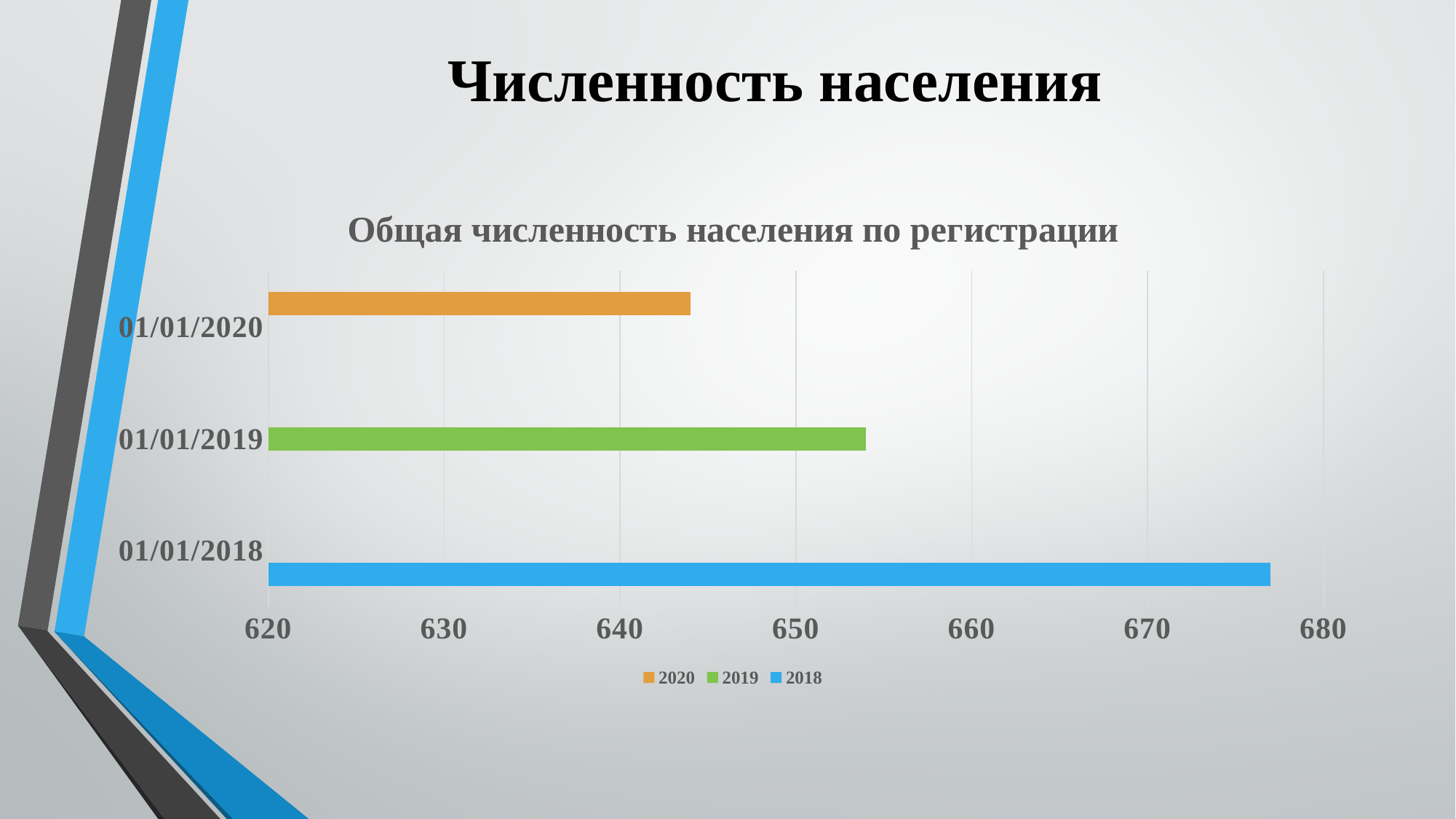
Is the value for 01/01/2019 greater or less than 650? greater Which category has the highest value? 01/01/2018 Which is larger, the value for 01/01/2019 or the value for 01/01/2020? 01/01/2019 What kind of chart is shown on the slide? bar chart How many series does the legend list? 3 How many categories are shown on the chart? 3 Do the values rise or fall from 01/01/2018 to 01/01/2020? fall Is the value for 01/01/2020 greater or less than 650? less Which category has the lowest value? 01/01/2020 What is the title of the chart? Общая численность населения по регистрации What colour is the bar for 01/01/2018? blue Is the value for 01/01/2018 greater or less than 670? greater